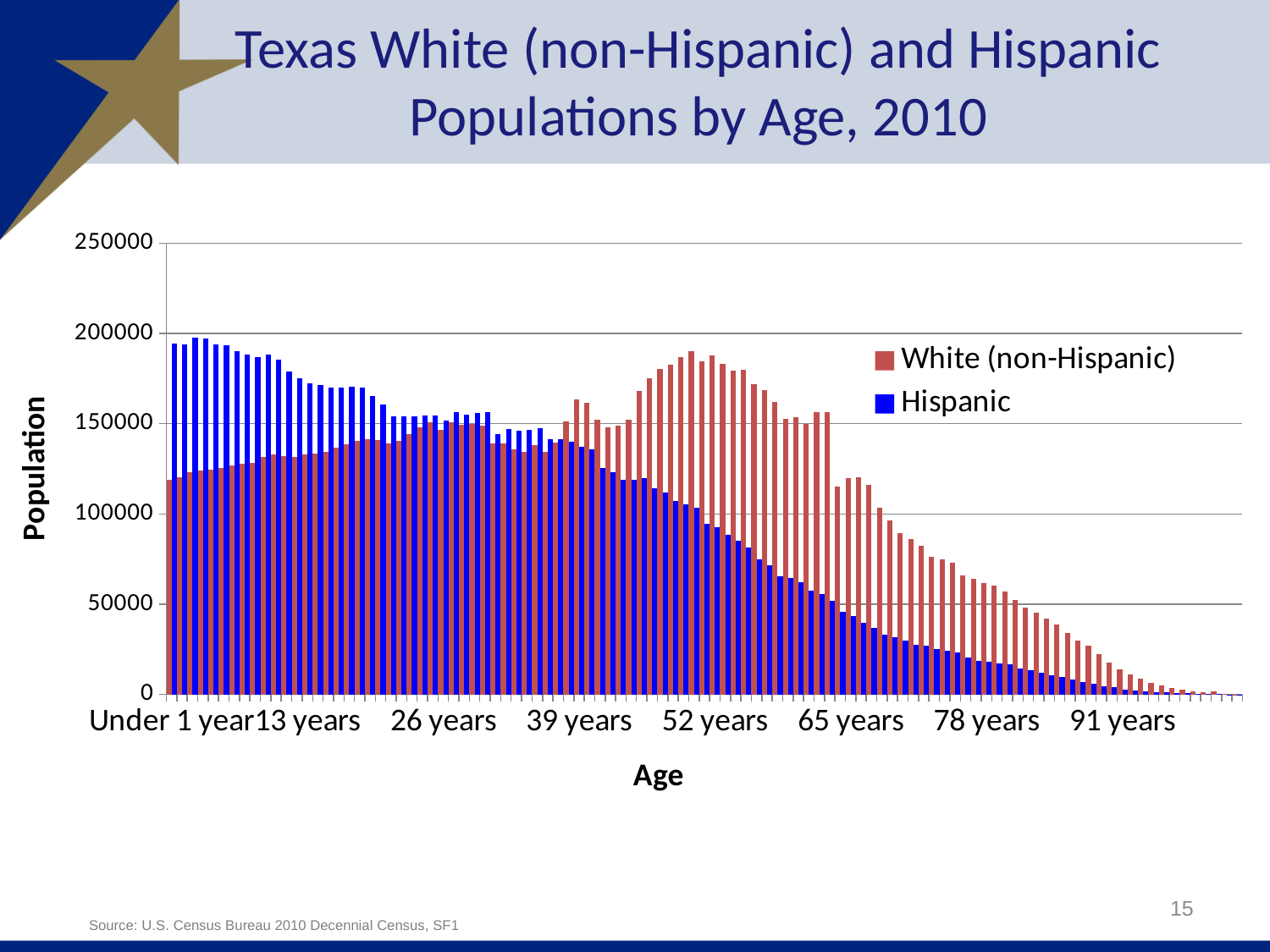
Which series has the larger value at Under 1 year, White (non-Hispanic) or Hispanic? Hispanic What kind of chart is shown on the slide? bar chart Which series has the larger value at 52 years, White (non-Hispanic) or Hispanic? White (non-Hispanic) What is the label of the vertical axis? Population Do the Hispanic values generally rise or fall from 39 years to 91 years? fall How many series does the legend list? 2 What are the two series named in the legend? White (non-Hispanic) and Hispanic Is the Hispanic value for Under 1 year greater or less than 150000? greater Is the White (non-Hispanic) value for Under 1 year greater or less than 150000? less Is the Hispanic value for 52 years greater or less than 100000? less